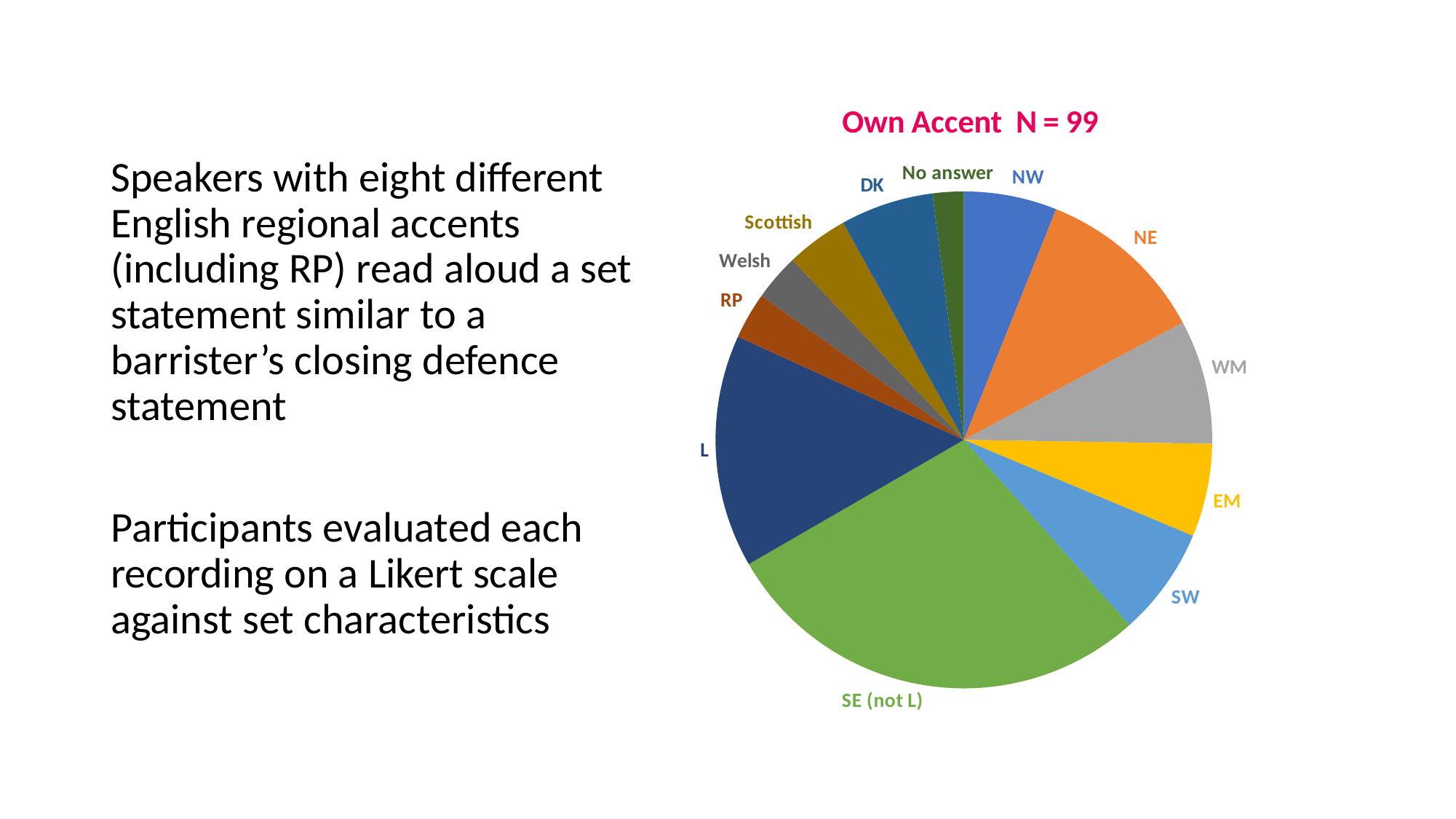
Which category has the smallest slice of the pie? No answer How many slices does the pie chart have? 12 Which slice is larger, L or NW? L Which slice is larger, SE (not L) or L? SE (not L) Which slice is larger, SW or Scottish? SW What is the value of N given in the chart title? 99 Which category has the largest slice of the pie? SE (not L) What is the title of the pie chart? Own Accent N = 99 What kind of chart is shown on the slide? pie chart